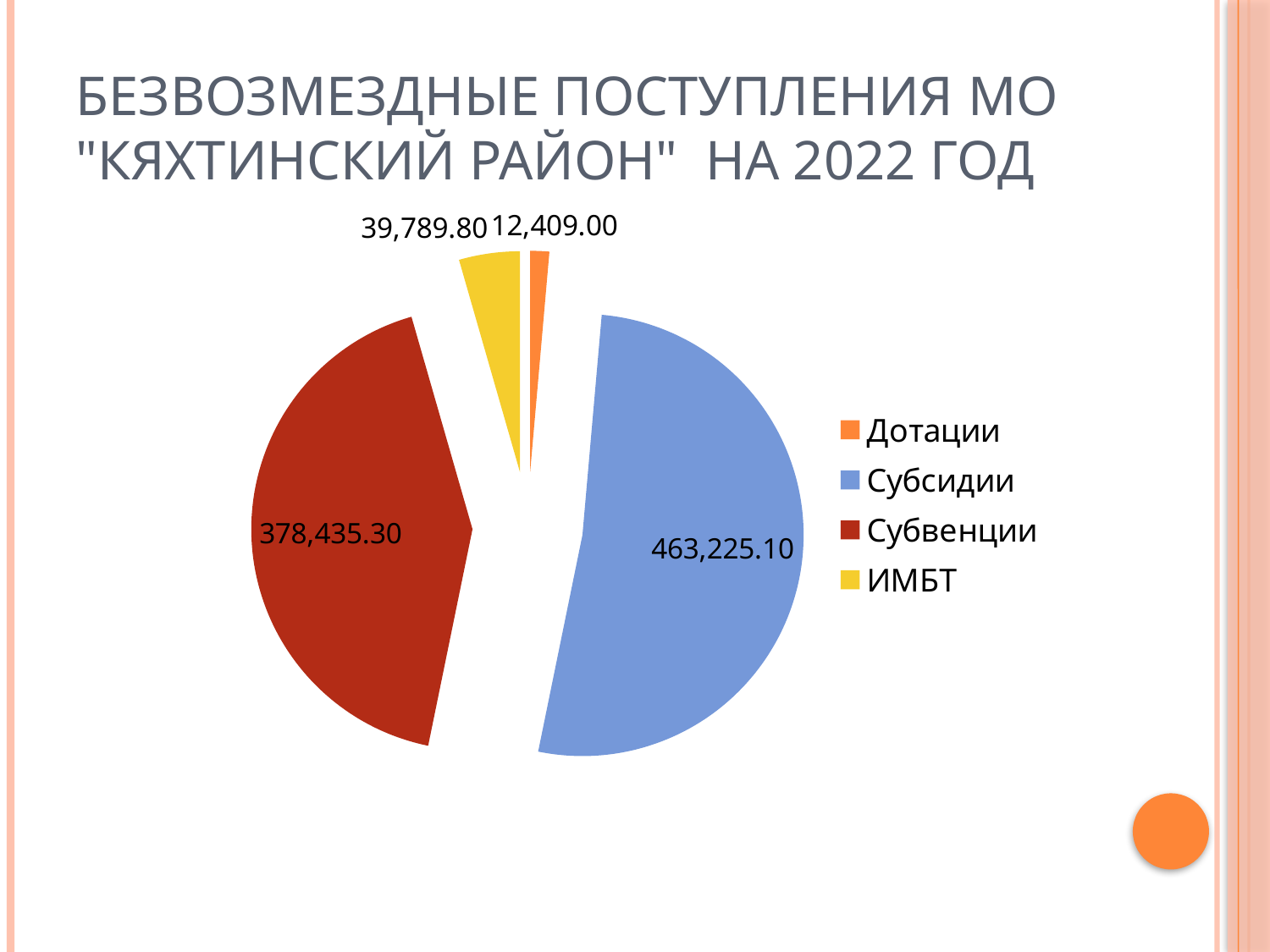
How many categories does the pie chart have? 4 Which is larger, the value for ИМБТ or the value for Дотации? ИМБТ Which category has the largest slice of the pie? Субсидии What is the total of all slices in the pie chart? 893,859.20 What is the value for Субсидии? 463,225.10 What type of chart is shown on the slide? Pie chart What is the value for Дотации? 12,409.00 Which category has the smallest slice of the pie? Дотации What colour is the slice for Субвенции? Red What is the value for Субвенции? 378,435.30 What is the value for ИМБТ? 39,789.80 What is the difference between the values for Субсидии and Субвенции? 84,789.80